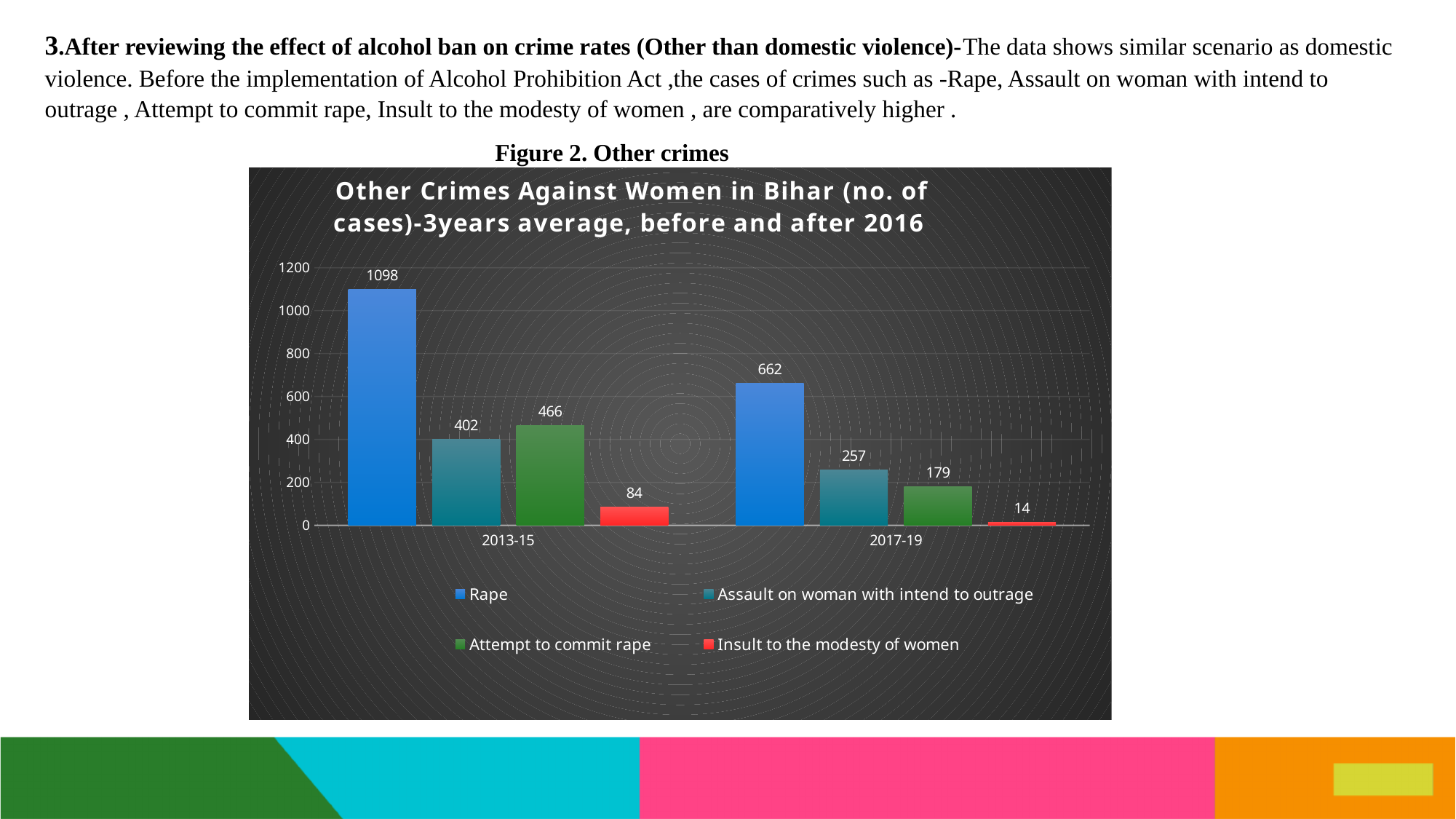
Which is larger in 2013-15: Assault on woman with intend to outrage or Attempt to commit rape? Attempt to commit rape How many series does the legend list? 4 How many categories are shown on the x axis? 2 What is the difference between the Rape values for 2013-15 and 2017-19? 436 What is the value for Insult to the modesty of women in 2017-19? 14 What kind of chart is shown? Bar chart What is the value for Rape in 2013-15? 1098 What is the value for Attempt to commit rape in 2013-15? 466 Which series has the lowest value in 2013-15? Insult to the modesty of women Does the value for Attempt to commit rape rise or fall from 2013-15 to 2017-19? Fall What is the value for Assault on woman with intend to outrage in 2017-19? 257 Which series has the highest value in 2017-19? Rape